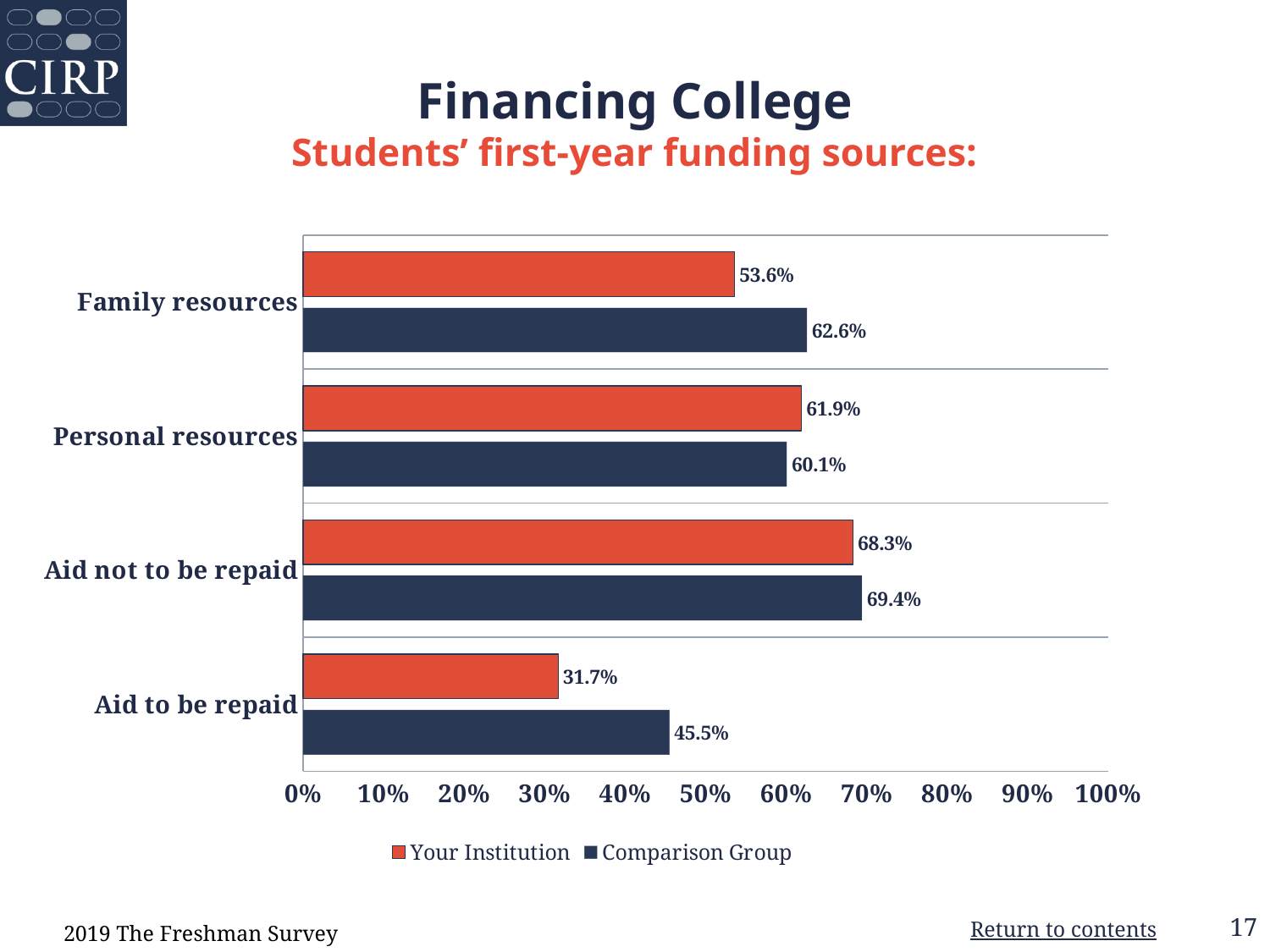
What is the difference between the Comparison Group and Your Institution values for Family resources? 9.0% How many categories are shown on the chart? 4 What is the difference between the Comparison Group and Your Institution values for Aid to be repaid? 13.8% How many series does the legend list? 2 Is the value for Your Institution for Aid to be repaid greater or less than 40%? less What is the value for Comparison Group for Aid to be repaid? 45.5% What kind of chart is shown on the slide? Bar chart For Personal resources, which is larger: Your Institution or Comparison Group? Your Institution Which category has the lowest value for Comparison Group? Aid to be repaid What is the value for Your Institution for Family resources? 53.6% Which category has the highest value for Your Institution? Aid not to be repaid What is the value for Comparison Group for Personal resources? 60.1%